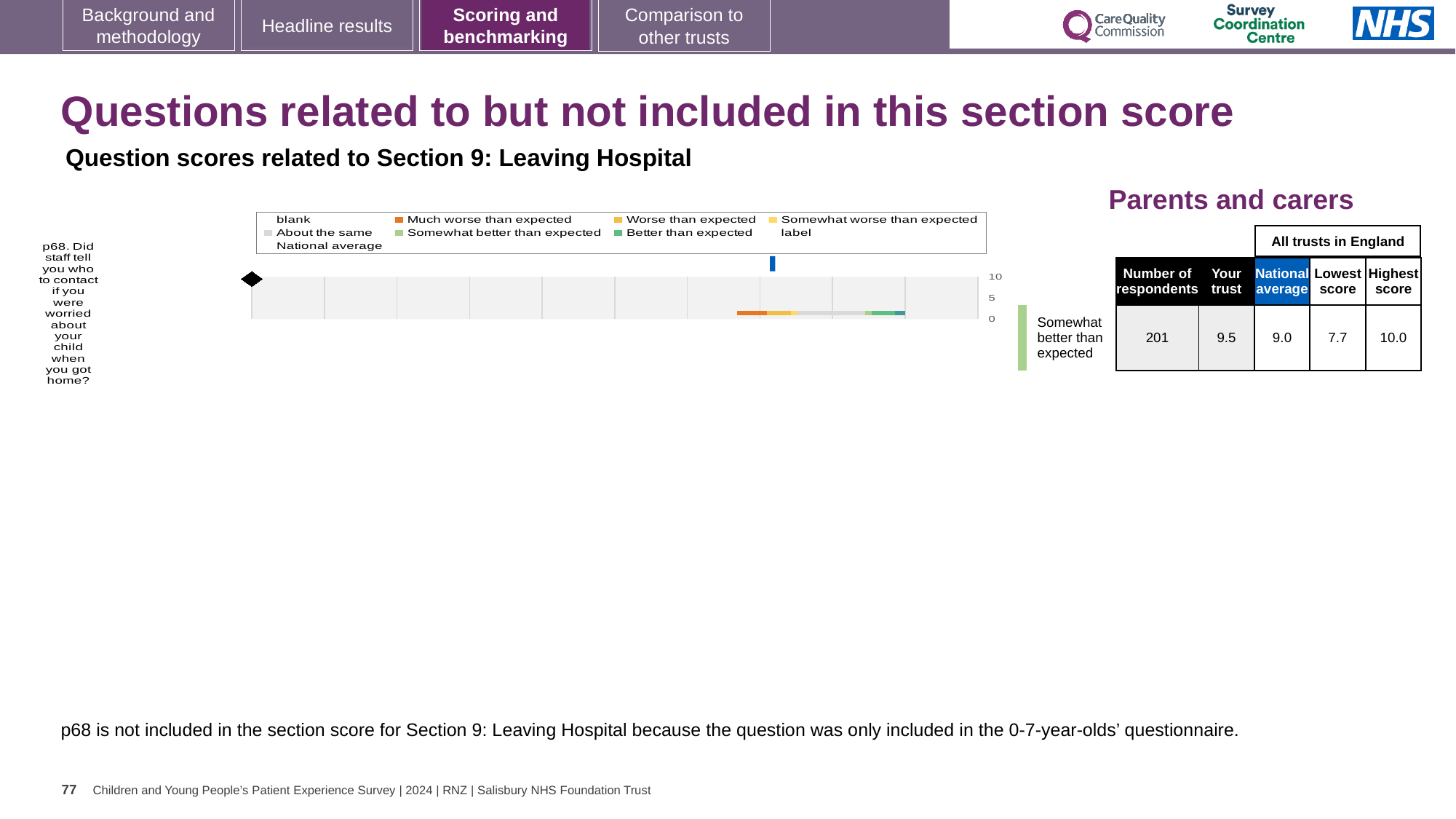
What benchmarking category is the trust's p68 result placed in? Somewhat better than expected How many respondents answered p68? 201 What is the 'Your trust' score for p68? 9.5 What is the difference between the trust's score and the national average for p68? 0.5 What is the lowest score among all trusts in England for p68? 7.7 What is the national average score for p68? 9.0 Which question is plotted in the benchmarking chart? p68. Did staff tell you who to contact if you were worried about your child when you got home? What kind of chart is used to show the p68 benchmarking result? bar chart What is the highest value shown on the chart's axis? 10 How many questions are plotted in the benchmarking chart? 1 Is the trust's score for p68 higher or lower than the national average? higher What is the highest score among all trusts in England for p68? 10.0